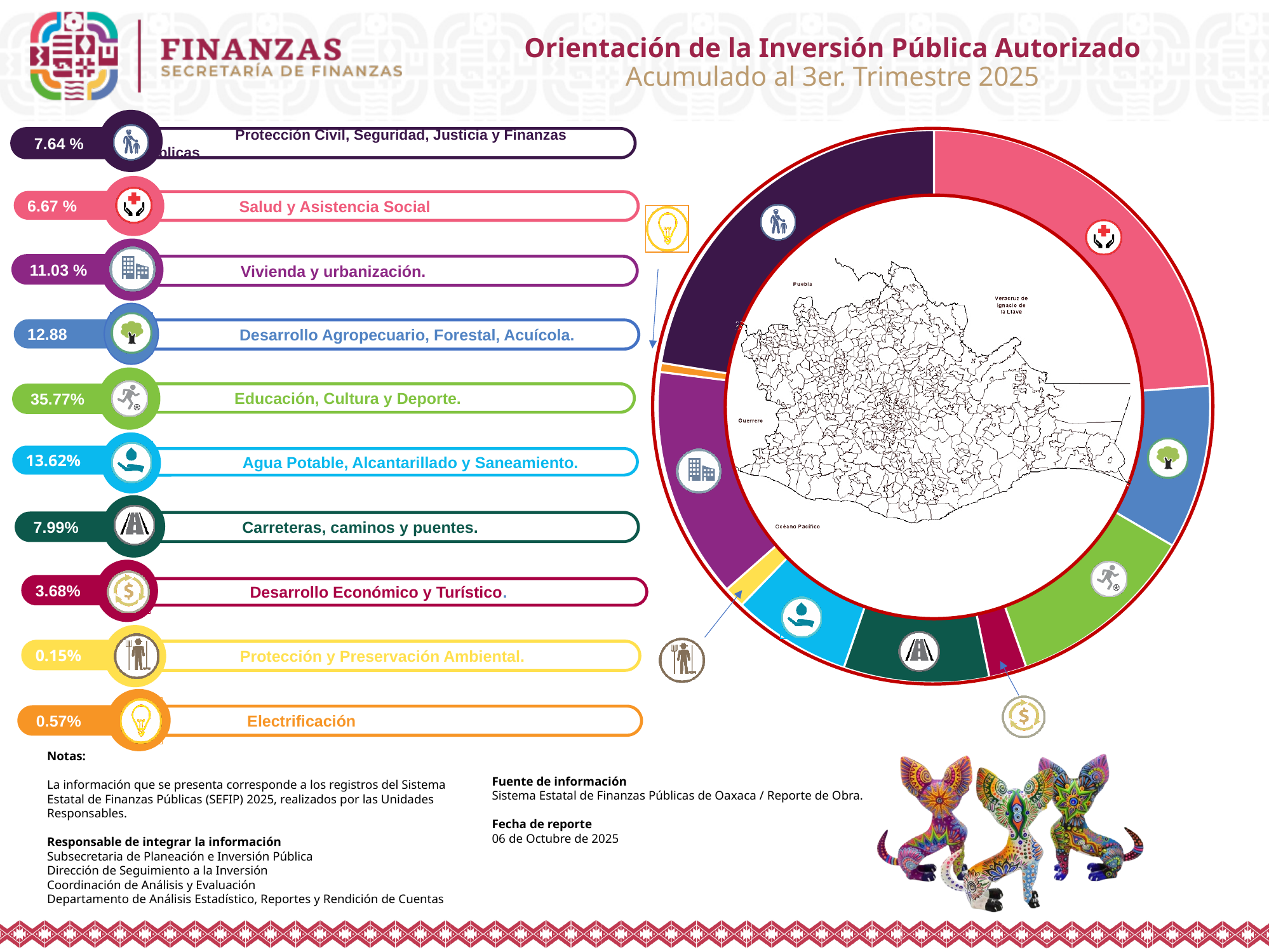
What is the difference in percentage points between Educación, Cultura y Deporte and Agua Potable, Alcantarillado y Saneamiento? 22.15 What kind of chart is shown on the slide? pie chart (donut) What is the value shown for Desarrollo Económico y Turístico? 3.68% What share of the authorized public investment goes to Educación, Cultura y Deporte? 35.77% What is the value shown for Electrificación? 0.57% What is the value shown for Agua Potable, Alcantarillado y Saneamiento? 13.62% How many categories are shown in the chart? 10 What is the difference in percentage points between Carreteras, caminos y puentes and Protección Civil, Seguridad, Justicia y Finanzas Públicas? 0.35 What is the value shown for Vivienda y urbanización? 11.03 %